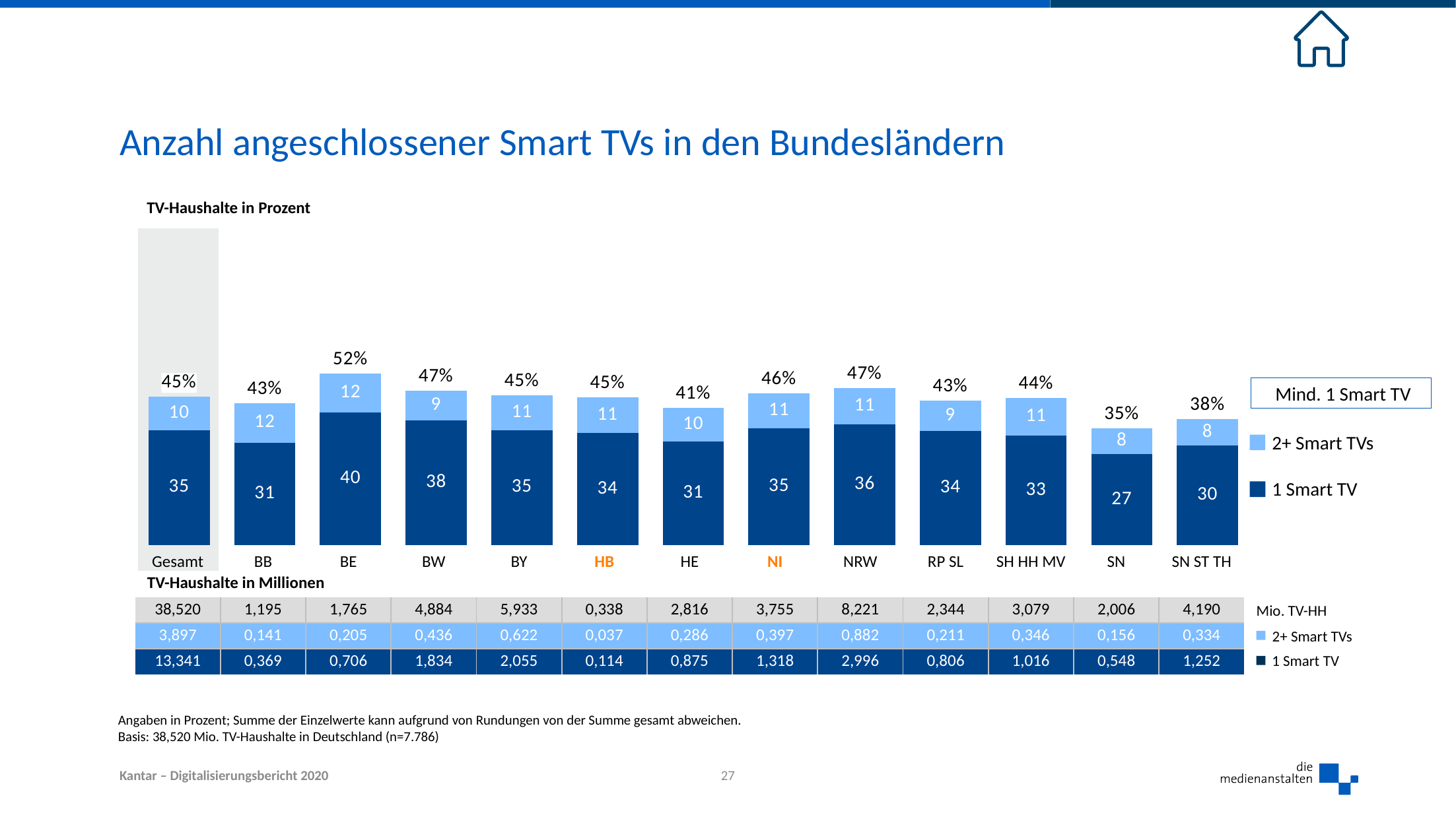
How many categories are shown along the x axis of the chart? 13 Which has the larger '1 Smart TV' value, BW or HE? BW Which category has the lowest 'Mind. 1 Smart TV' total? SN How many series does the chart legend list? 2 In the table 'TV-Haushalte in Millionen', what is the '1 Smart TV' value for BY? 2,055 What is the difference between the '1 Smart TV' values for BE and SN? 13 What is the 'Mind. 1 Smart TV' total shown above the bar for BE? 52% What type of chart is shown on the slide? Stacked bar chart Which category has the highest 'Mind. 1 Smart TV' total? BE In the table 'TV-Haushalte in Millionen', what is the 'Mio. TV-HH' value for NRW? 8,221 What is the '2+ Smart TVs' value for SN? 8 What is the '1 Smart TV' value for BE? 40